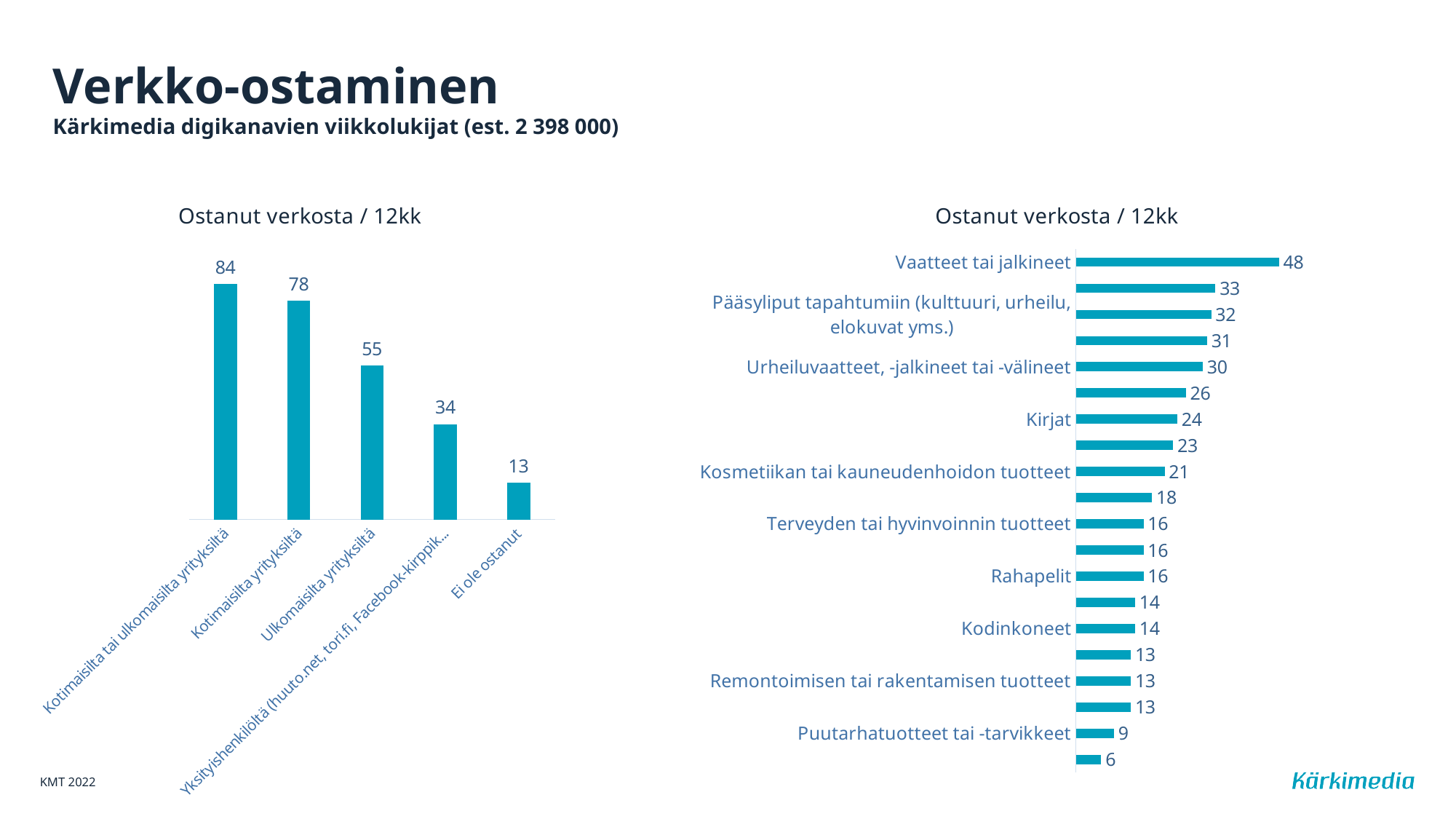
What kind of chart is the left chart? bar chart How many bars does the left chart have? 5 On the left chart, which category has the highest value? Kotimaisilta tai ulkomaisilta yrityksiltä On the left chart, what is the value for Kotimaisilta yrityksiltä? 78 On the left chart, what is the difference between Kotimaisilta yrityksiltä and Ulkomaisilta yrityksiltä? 23 On the left chart, what is the value for Ei ole ostanut? 13 On the right chart, what is the value for Puutarhatuotteet tai -tarvikkeet? 9 On the right chart, what is the value for Vaatteet tai jalkineet? 48 On the right chart, what is the difference between Vaatteet tai jalkineet and Kodinkoneet? 34 On the right chart, which is larger, Urheiluvaatteet, -jalkineet tai -välineet or Kosmetiikan tai kauneudenhoidon tuotteet? Urheiluvaatteet, -jalkineet tai -välineet How many bars does the right chart have? 20 On the right chart, what is the value for Kirjat? 24